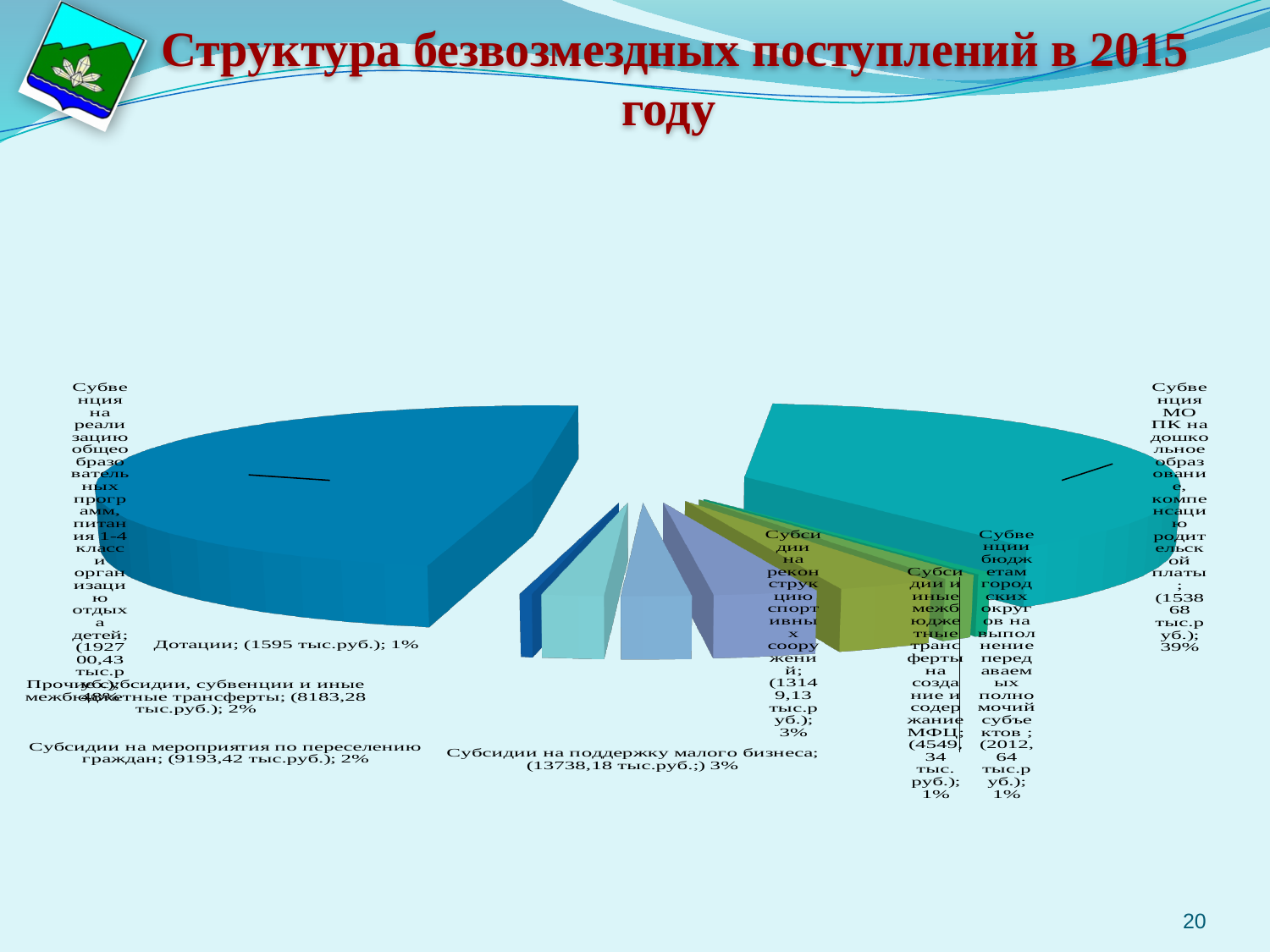
What is the value shown for Дотации? 1595 тыс.руб. What kind of chart is shown on the slide? pie chart Which category has the smallest value in the pie chart? Дотации What is the title of the chart on the slide? Структура безвозмездных поступлений в 2015 году Which category has the largest slice of the pie? Субвенция на реализацию общеобразовательных программ, питания 1-4 класс и организацию отдыха детей What share of the pie does Субсидии на реконструкцию спортивных сооружений represent? 3% How many slices does the pie chart have? 9 What is the difference between the value for Субсидии и иные межбюджетные трансферты на создание и содержание МФЦ and the value for Субвенции бюджетам городских округов на выполнение передаваемых полномочий субъектов? 2536,70 тыс.руб. What share of the pie does Субвенция МО ПК на дошкольное образование, компенсацию родительской платы represent? 39% What is the value shown for Субсидии на мероприятия по переселению граждан? 9193,42 тыс.руб. What is the value shown for Субсидии на поддержку малого бизнеса? 13738,18 тыс.руб. Which is larger: the value for Субсидии на поддержку малого бизнеса or the value for Субсидии на мероприятия по переселению граждан? Субсидии на поддержку малого бизнеса